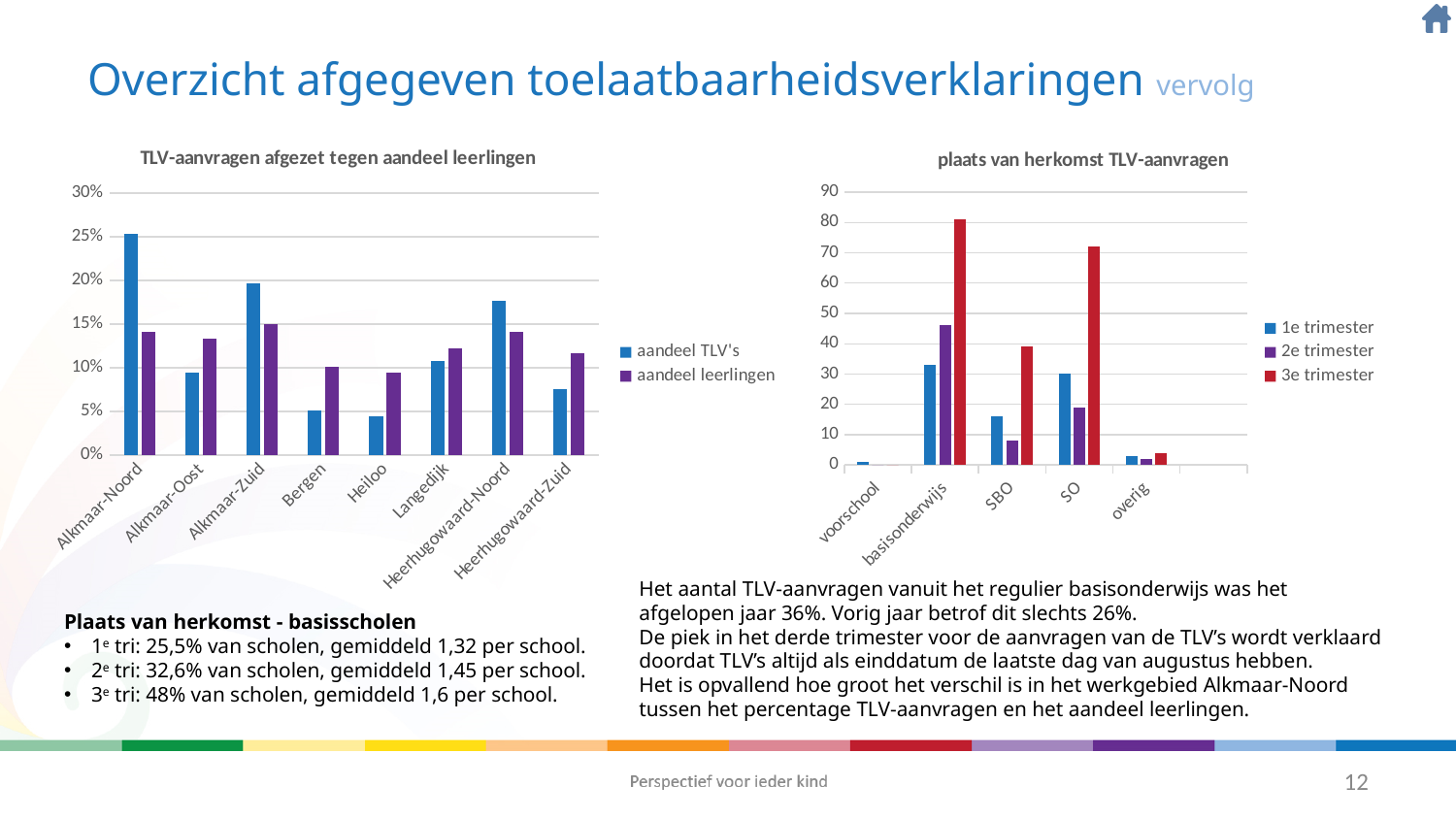
On the chart titled 'TLV-aanvragen afgezet tegen aandeel leerlingen', which category has the highest value for 'aandeel TLV's'? Alkmaar-Noord On the chart titled 'TLV-aanvragen afgezet tegen aandeel leerlingen', for Heerhugowaard-Noord, which is larger: 'aandeel TLV's' or 'aandeel leerlingen'? aandeel TLV's On the chart titled 'TLV-aanvragen afgezet tegen aandeel leerlingen', what kind of chart is shown? bar chart On the chart titled 'TLV-aanvragen afgezet tegen aandeel leerlingen', how many series does the legend list? 2 On the chart titled 'plaats van herkomst TLV-aanvragen', is the '3e trimester' value for SO greater or less than 60? greater On the chart titled 'plaats van herkomst TLV-aanvragen', which category has the highest value for '3e trimester'? basisonderwijs On the chart titled 'TLV-aanvragen afgezet tegen aandeel leerlingen', how many categories are shown on the x axis? 8 On the chart titled 'plaats van herkomst TLV-aanvragen', how many categories are shown on the x axis? 5 On the chart titled 'plaats van herkomst TLV-aanvragen', for SBO, which is larger: '1e trimester' or '2e trimester'? 1e trimester On the chart titled 'TLV-aanvragen afgezet tegen aandeel leerlingen', for Bergen, which is larger: 'aandeel TLV's' or 'aandeel leerlingen'? aandeel leerlingen On the chart titled 'plaats van herkomst TLV-aanvragen', how many series does the legend list? 3 On the chart titled 'TLV-aanvragen afgezet tegen aandeel leerlingen', is the 'aandeel TLV's' value for Alkmaar-Noord greater or less than 20%? greater